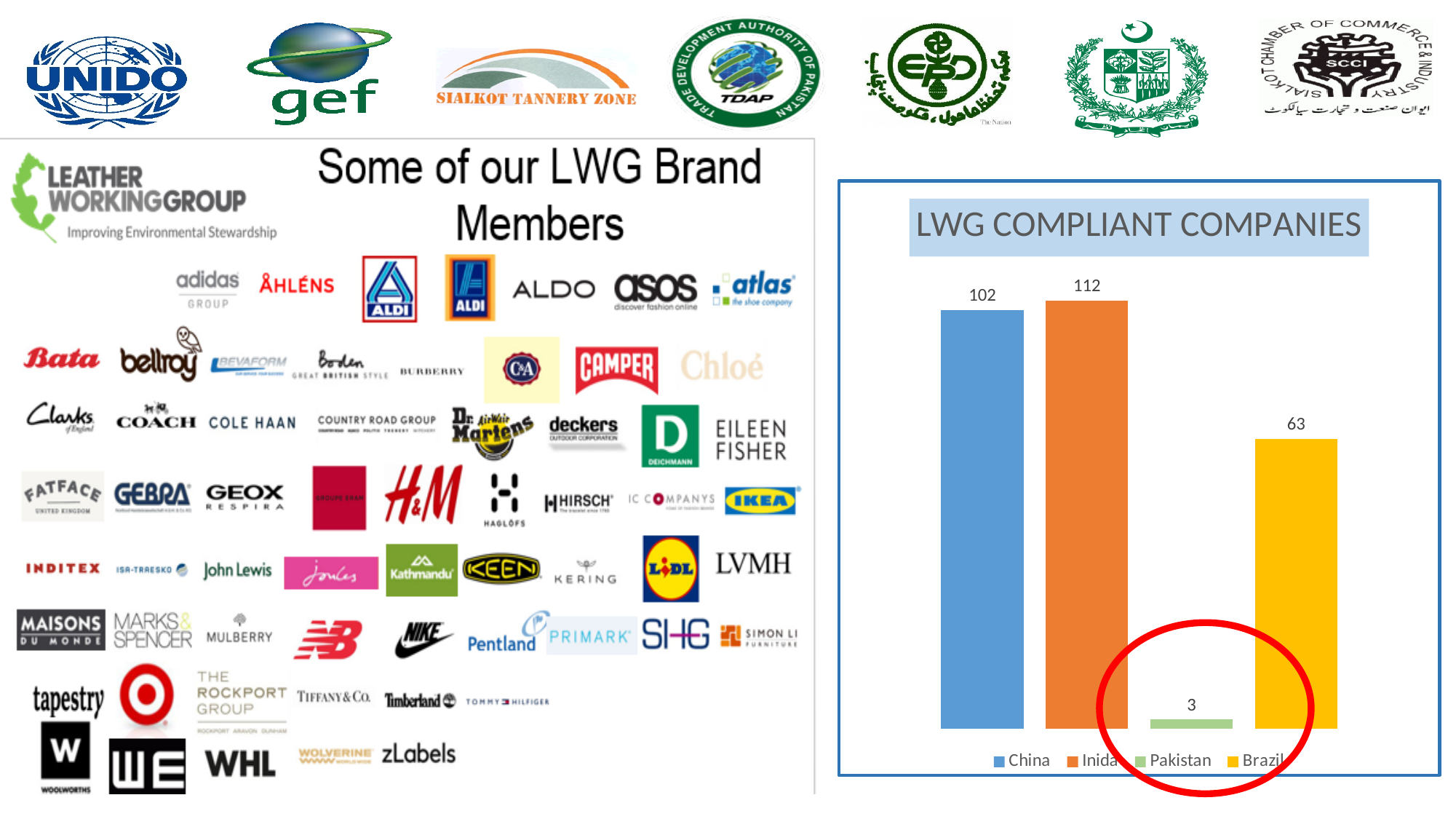
What type of chart is the LWG Compliant Companies chart? Bar chart What is the value for Inida in the LWG Compliant Companies chart? 112 What is the difference between the values for Inida and China in the LWG Compliant Companies chart? 10 How many countries are shown in the LWG Compliant Companies chart? 4 What is the value for Pakistan in the LWG Compliant Companies chart? 3 What is the value for China in the LWG Compliant Companies chart? 102 Which country has the lowest number of LWG compliant companies? Pakistan Which is larger in the LWG Compliant Companies chart, China or Brazil? China What is the difference between the values for Brazil and Pakistan in the LWG Compliant Companies chart? 60 What is the value for Brazil in the LWG Compliant Companies chart? 63 What is the title of the chart on the right side of the slide? LWG COMPLIANT COMPANIES Which country has the highest number of LWG compliant companies? Inida